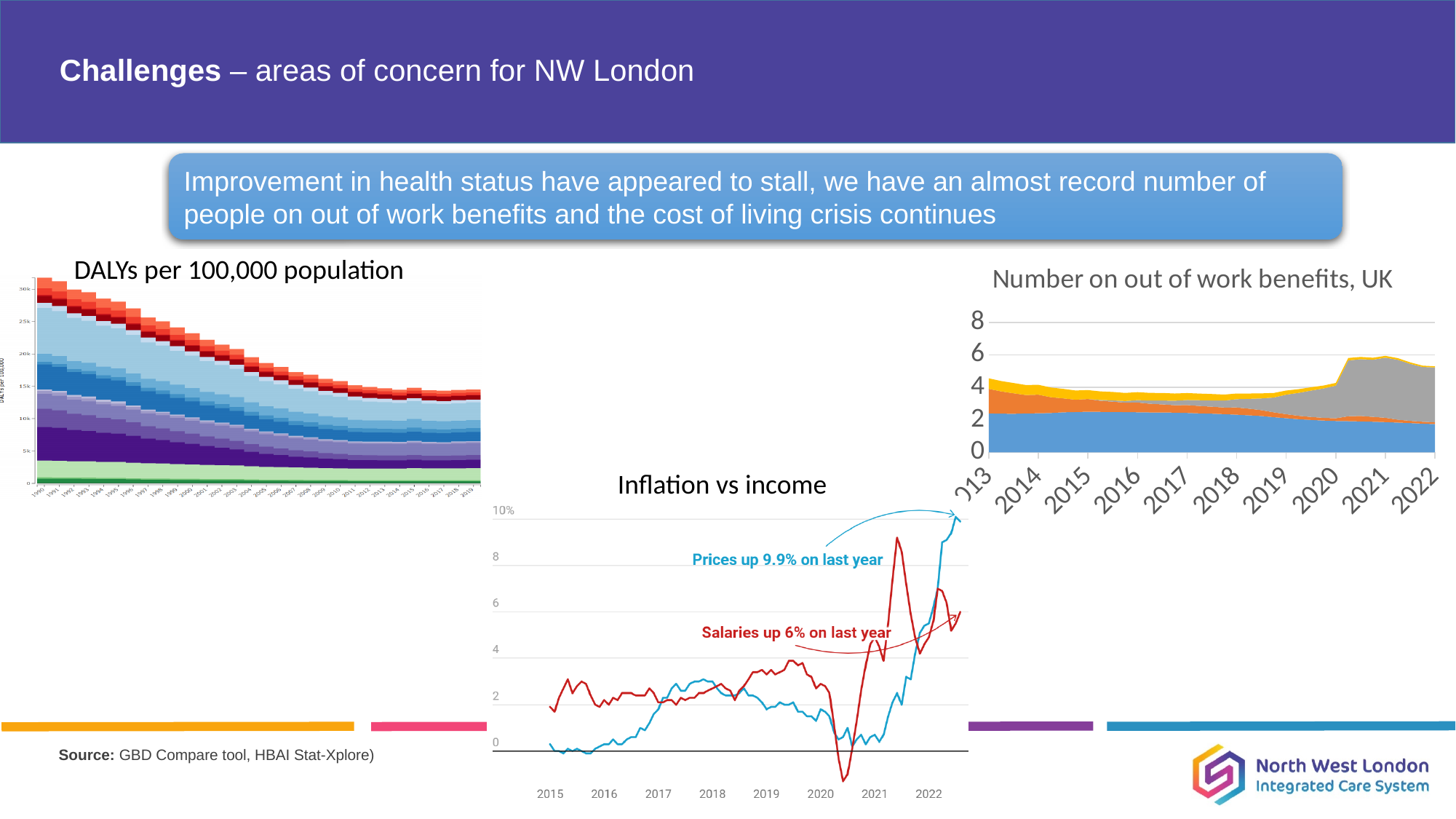
In the 'Inflation vs income' chart, which is larger at the end of the series: the rise in prices or the rise in salaries? Prices In the 'Number on out of work benefits, UK' chart, does the grey area rise or fall between 2019 and 2021? Rise In the 'DALYs per 100,000 population' chart, do the total DALYs rise or fall from 1990 to 2019? Fall In the 'Inflation vs income' chart, by how much are prices up on last year according to the annotation? 9.9% In the 'Number on out of work benefits, UK' chart, is the total value for 2021 greater or less than 4? greater In the 'DALYs per 100,000 population' chart, is the total value for 2019 greater or less than 20k? less In the 'Inflation vs income' chart, does the prices line rise or fall between 2021 and 2022? Rise In the 'Inflation vs income' chart, what is the first year shown on the x axis? 2015 In the 'Inflation vs income' chart, by how much are salaries up on last year according to the annotation? 6% In the 'DALYs per 100,000 population' chart, is the total value for 1990 greater or less than 30k? greater What kind of chart is 'Inflation vs income'? Line chart